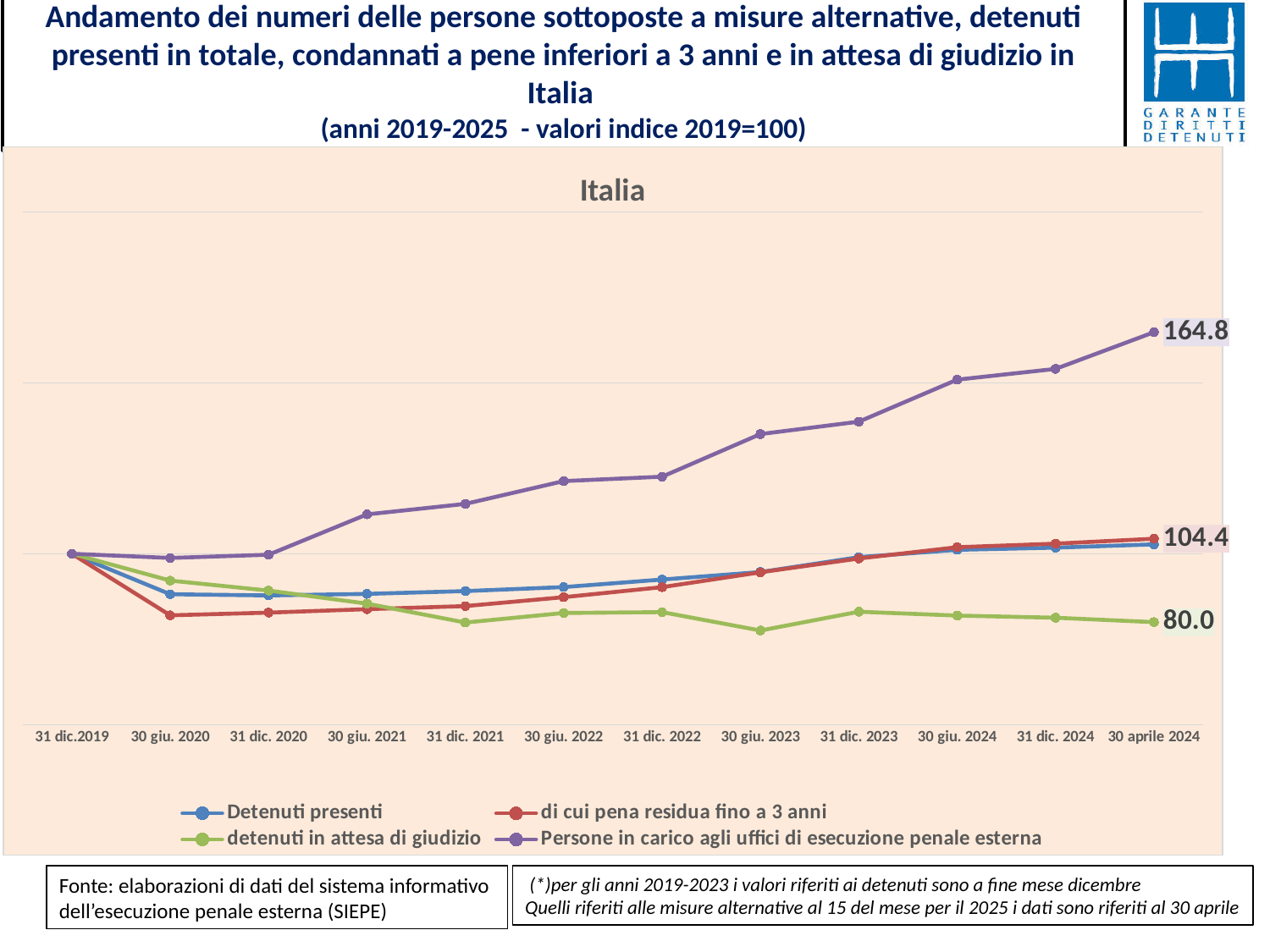
What kind of chart is shown on the slide? line chart What is the first date label on the x axis? 31 dic.2019 What is the value labelled at the end of the 'Persone in carico agli uffici di esecuzione penale esterna' line? 164.8 Does the 'Persone in carico agli uffici di esecuzione penale esterna' line rise or fall from the first to the last date? rise How many series does the legend list? 4 What is the value labelled at the end of the 'detenuti in attesa di giudizio' line? 80.0 Which series has the highest value at the last date on the x axis? Persone in carico agli uffici di esecuzione penale esterna What is the title shown inside the chart area? Italia At the last date, which is larger: the value for 'Persone in carico agli uffici di esecuzione penale esterna' or for 'detenuti in attesa di giudizio'? Persone in carico agli uffici di esecuzione penale esterna Which series has the lowest value at the last date on the x axis? detenuti in attesa di giudizio How many dates are shown along the x axis? 12 What is the difference between the final labelled values of the 'Persone in carico agli uffici di esecuzione penale esterna' line and the 'detenuti in attesa di giudizio' line? 84.8